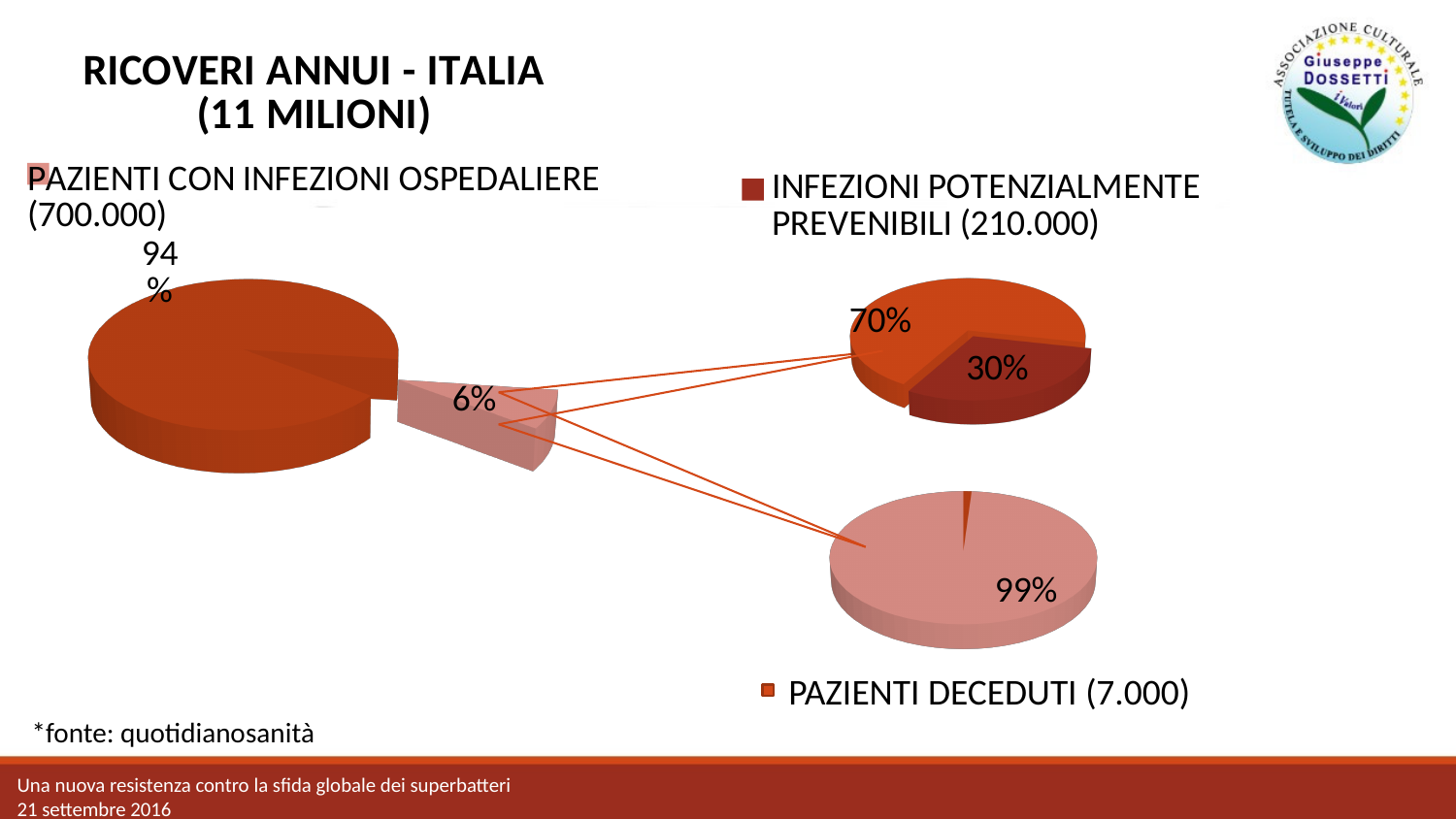
In the 'INFEZIONI POTENZIALMENTE PREVENIBILI (210.000)' pie chart, what percentage is shown on the larger slice? 70% In the 'RICOVERI ANNUI - ITALIA' pie chart, what percentage is shown on the pulled-out slice for PAZIENTI CON INFEZIONI OSPEDALIERE? 6% How many pie charts are shown on the slide? 3 In the 'INFEZIONI POTENZIALMENTE PREVENIBILI (210.000)' pie chart, what percentage is shown on the smaller, darker slice? 30% In the 'INFEZIONI POTENZIALMENTE PREVENIBILI' pie chart, which slice is larger, the 70% slice or the 30% slice? the 70% slice In the 'RICOVERI ANNUI - ITALIA' pie chart, what is the difference in percentage points between the 94% slice and the 6% slice? 88 percentage points In the 'PAZIENTI DECEDUTI (7.000)' pie chart, what percentage is shown on the large slice? 99% What kind of chart is the large chart on the left under the title 'RICOVERI ANNUI - ITALIA (11 MILIONI)'? pie chart How many slices does the 'RICOVERI ANNUI - ITALIA' pie chart have? 2 What number in parentheses is given in the title 'RICOVERI ANNUI - ITALIA'? 11 MILIONI What number is given in parentheses in the legend label 'PAZIENTI DECEDUTI'? 7.000 In the 'RICOVERI ANNUI - ITALIA' pie chart, what percentage is shown on the largest slice? 94%